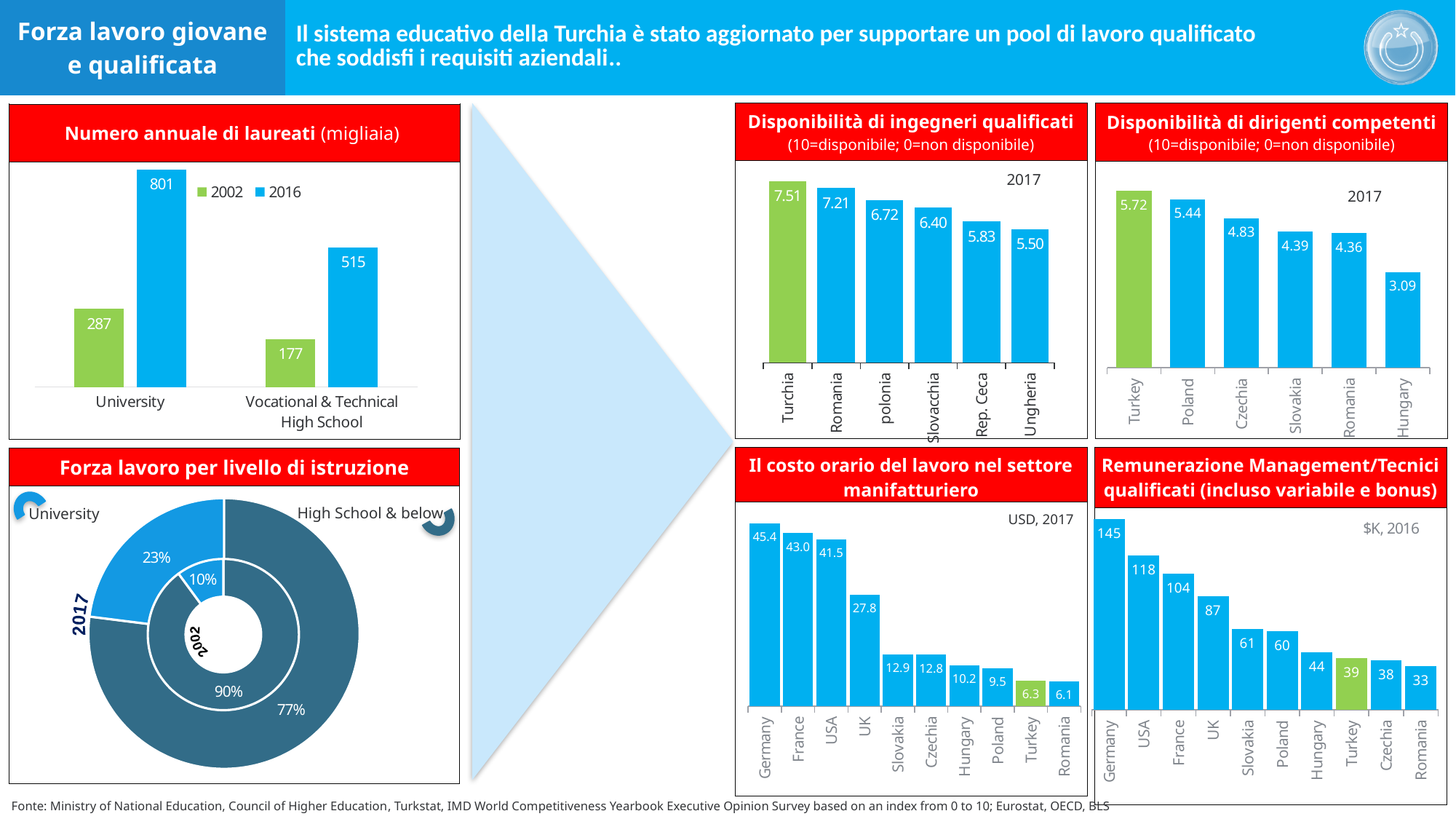
In the 'Numero annuale di laureati' chart, what is the 2016 value for University? 801 In the 'Disponibilità di ingegneri qualificati' chart, which country has the highest value? Turchia In the 'Numero annuale di laureati' chart, how many series does the legend list? 2 In the 'Disponibilità di dirigenti competenti' chart, how many countries are shown? 6 What kind of chart is 'Forza lavoro per livello di istruzione'? Doughnut chart In the 'Il costo orario del lavoro nel settore manifatturiero' chart, what is the value for Turkey? 6.3 In the 'Il costo orario del lavoro nel settore manifatturiero' chart, which is larger, the value for Slovakia or the value for Hungary? Slovakia In the 'Remunerazione Management/Tecnici qualificati' chart, what is the difference between Germany and Turkey? 106 In the 'Forza lavoro per livello di istruzione' chart, what share of the 2017 ring is University? 23% In the 'Numero annuale di laureati' chart, what is the difference between the 2016 and 2002 values for Vocational & Technical High School? 338 In the 'Disponibilità di ingegneri qualificati' chart, what is the value for Slovacchia? 6.40 In the 'Disponibilità di dirigenti competenti' chart, which country has the lowest value? Hungary